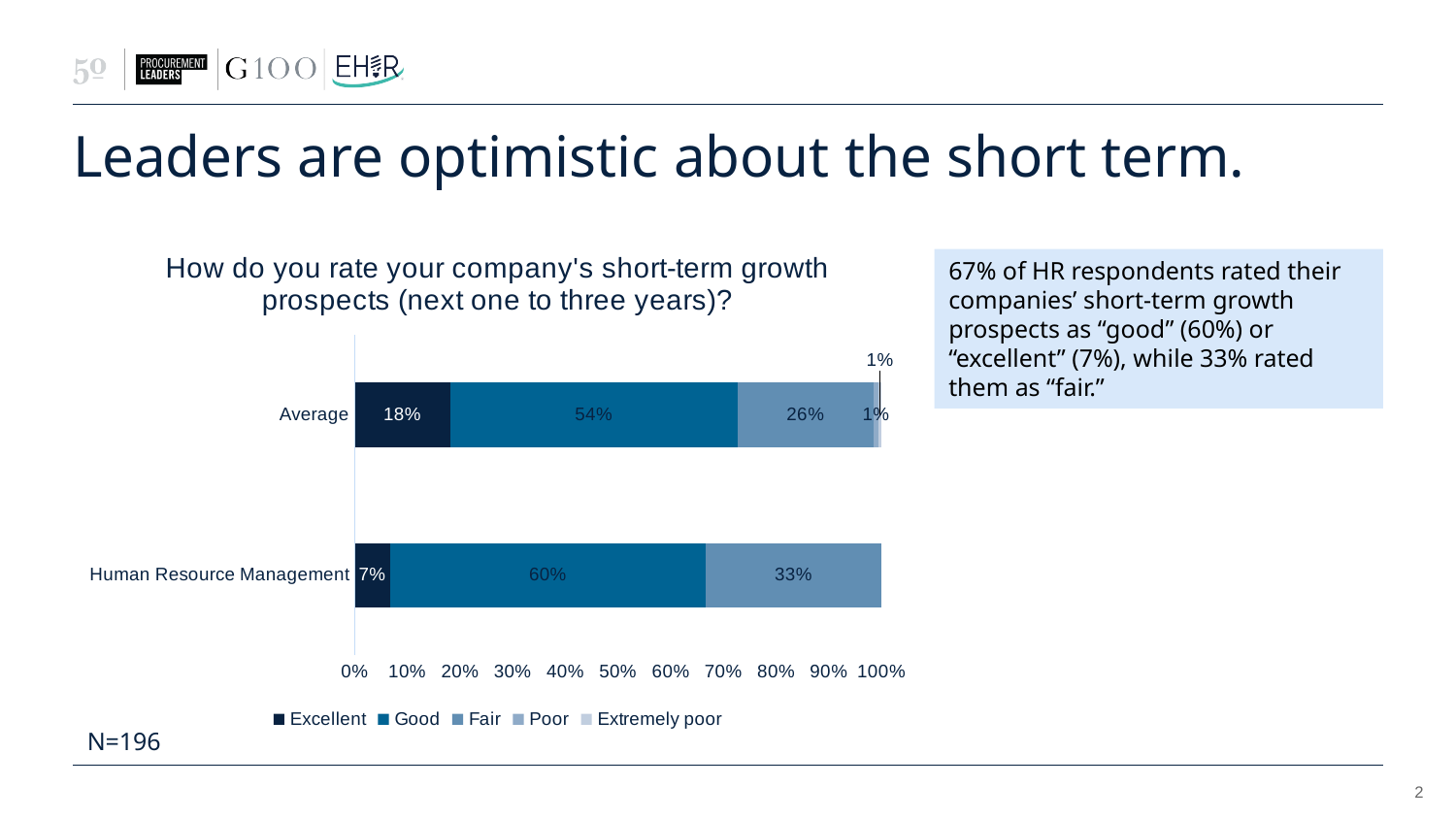
What is the "Excellent" value for Average? 18% Which category has the higher "Excellent" value, Average or Human Resource Management? Average What is the difference between the "Good" values for Human Resource Management and Average? 6% How many categories are shown on the chart? 2 What is the "Good" value for Human Resource Management? 60% What is the "Fair" value for Average? 26% How many series does the legend list? 5 What is the "Fair" value for Human Resource Management? 33% What is the combined "Excellent" and "Good" share for Human Resource Management? 67% What is the title of the chart? How do you rate your company's short-term growth prospects (next one to three years)? What kind of chart is shown on the slide? Stacked bar chart What is the "Poor" value for Average? 1%